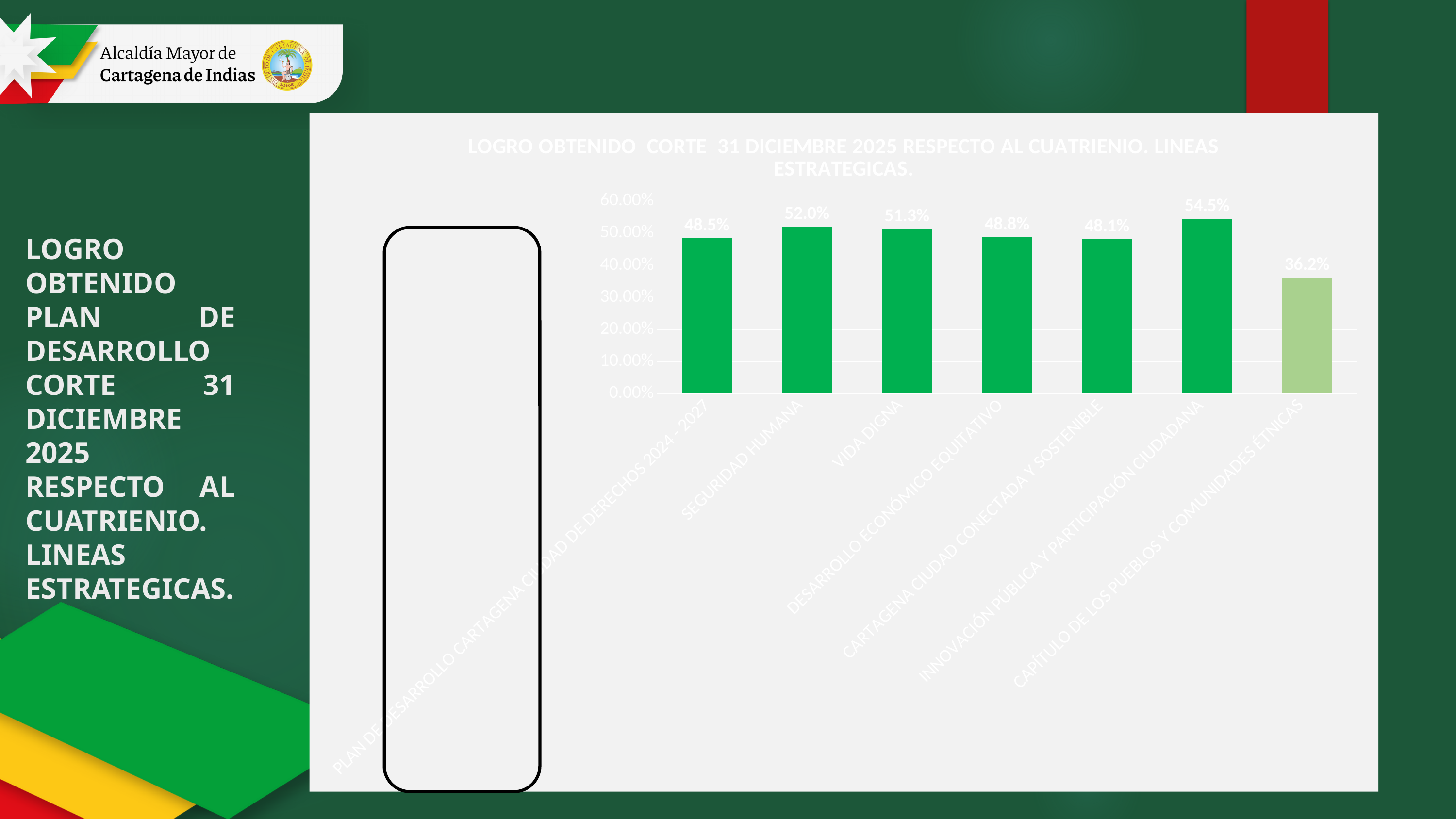
What is the title of the chart? LOGRO OBTENIDO CORTE 31 DICIEMBRE 2025 RESPECTO AL CUATRIENIO. LINEAS ESTRATEGICAS. What is the value for VIDA DIGNA? 51.3% Which category has the lowest value? CAPÍTULO DE LOS PUEBLOS Y COMUNIDADES ÉTNICAS What is the value for SEGURIDAD HUMANA? 52.0% What is the difference between the values for INNOVACIÓN PÚBLICA Y PARTICIPACIÓN CIUDADANA and CAPÍTULO DE LOS PUEBLOS Y COMUNIDADES ÉTNICAS? 18.3% How many categories are shown in the chart? 7 What kind of chart is shown on the slide? bar chart What is the value for CAPÍTULO DE LOS PUEBLOS Y COMUNIDADES ÉTNICAS? 36.2% Which category has the highest value? INNOVACIÓN PÚBLICA Y PARTICIPACIÓN CIUDADANA Which is larger, the value for SEGURIDAD HUMANA or the value for VIDA DIGNA? SEGURIDAD HUMANA What is the value for INNOVACIÓN PÚBLICA Y PARTICIPACIÓN CIUDADANA? 54.5% Is the value for CARTAGENA CIUDAD CONECTADA Y SOSTENIBLE greater or less than 50.00%? less